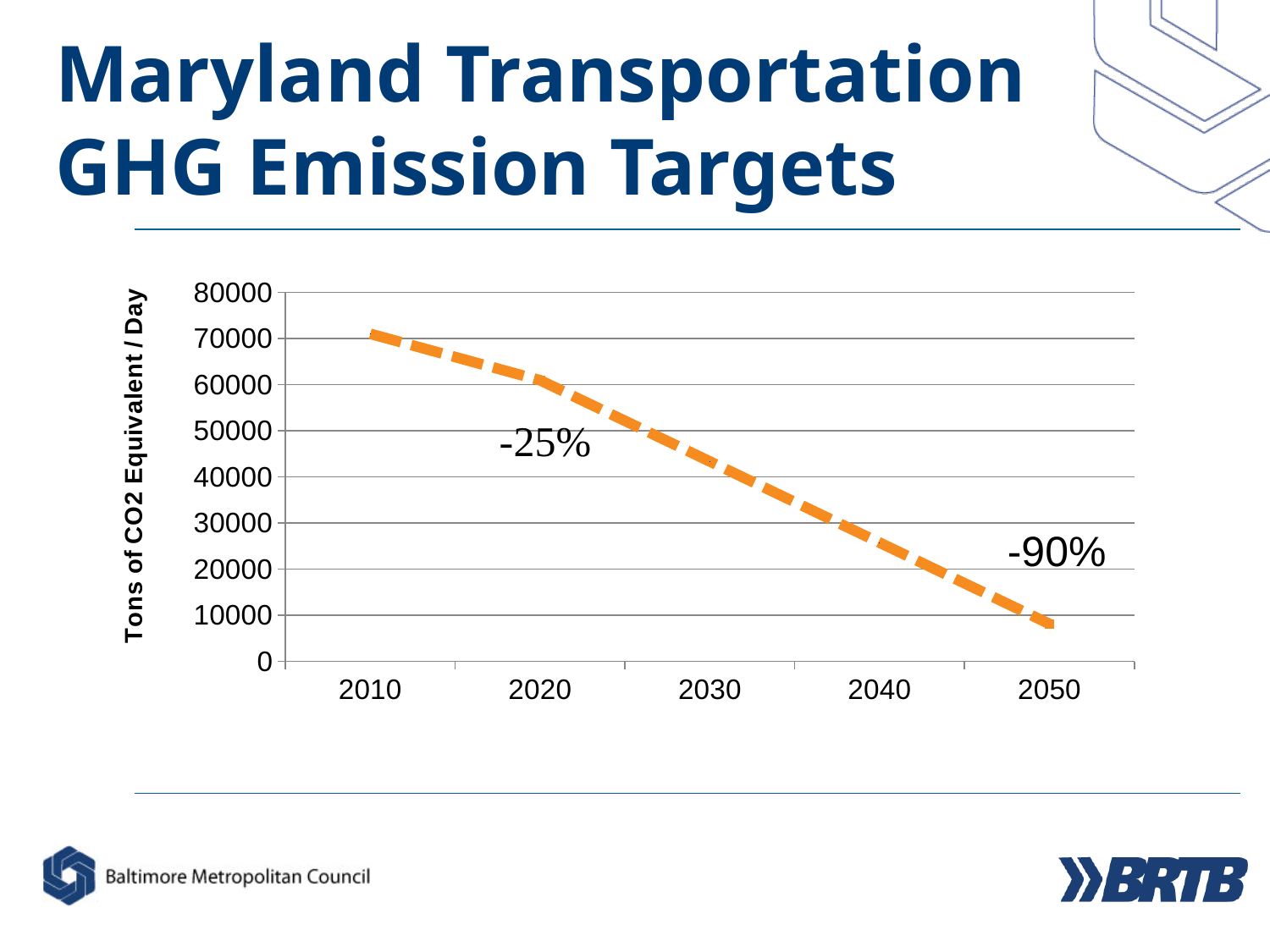
Is the value for 2050 greater or less than 20000? less Which is larger, the value for 2020 or the value for 2040? 2020 Is the value for 2010 greater or less than 60000? greater Is the value for 2020 greater or less than 50000? greater Do the values rise or fall from 2010 to 2050? fall Which year has the highest value on the chart? 2010 What is the label on the y axis? Tons of CO2 Equivalent / Day Which year has the lowest value on the chart? 2050 What kind of chart is shown on the slide? line chart How many years are labeled on the x axis? 5 What percentage reduction is annotated near the 2050 end of the line? -90%